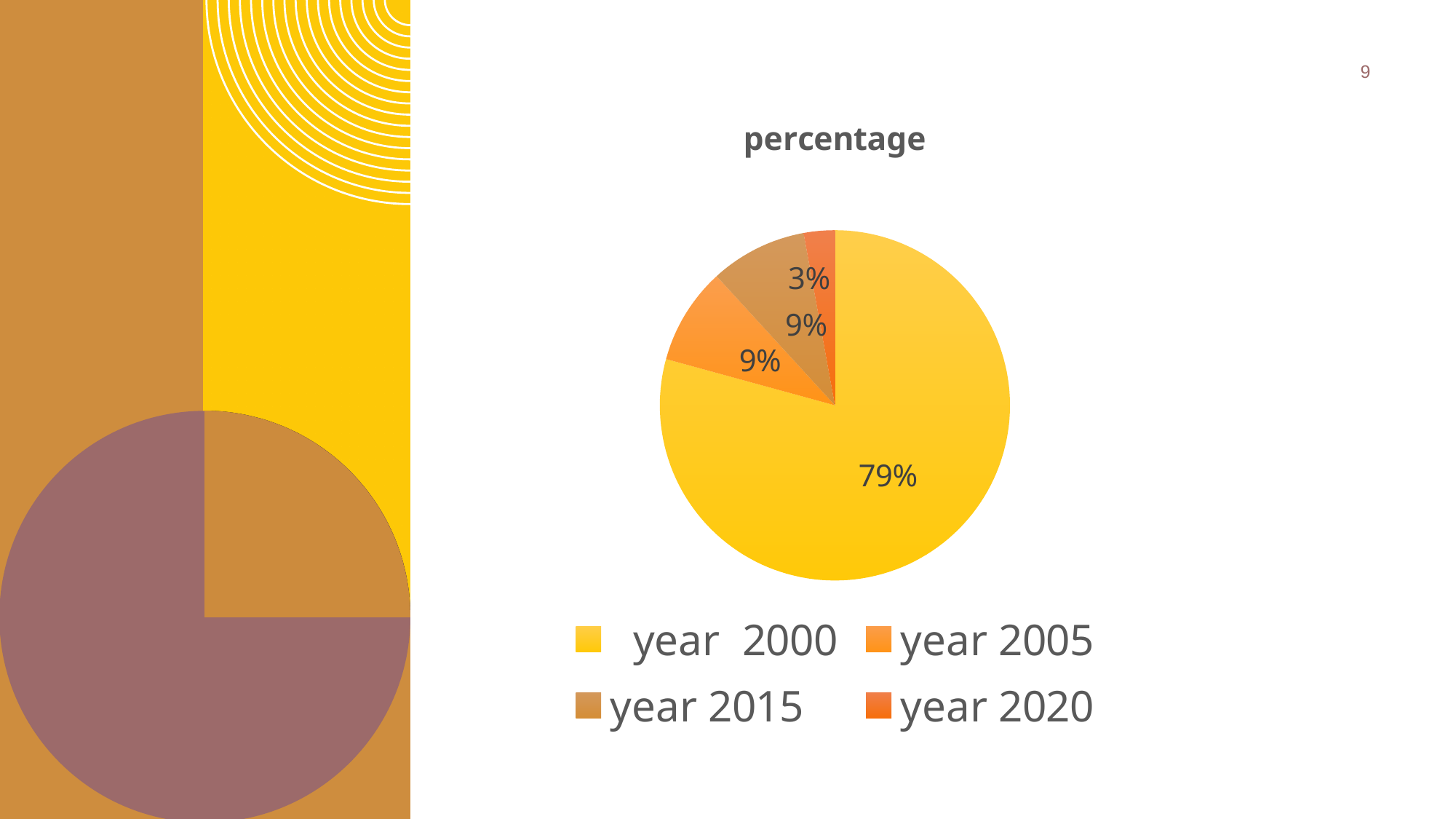
Which is larger, the share for year 2005 or the share for year 2020? year 2005 Which year has the smallest share of the pie? year 2020 What percentage does the year 2015 slice represent? 9% What is the title of the chart? percentage What type of chart is shown on the slide? pie chart Which year has the largest share of the pie? year 2000 What percentage does the year 2000 slice represent? 79% What percentage does the year 2005 slice represent? 9% What percentage does the year 2020 slice represent? 3% How many slices does the pie chart have? 4 What is the difference between the year 2000 share and the year 2020 share? 76% How many entries does the legend list? 4